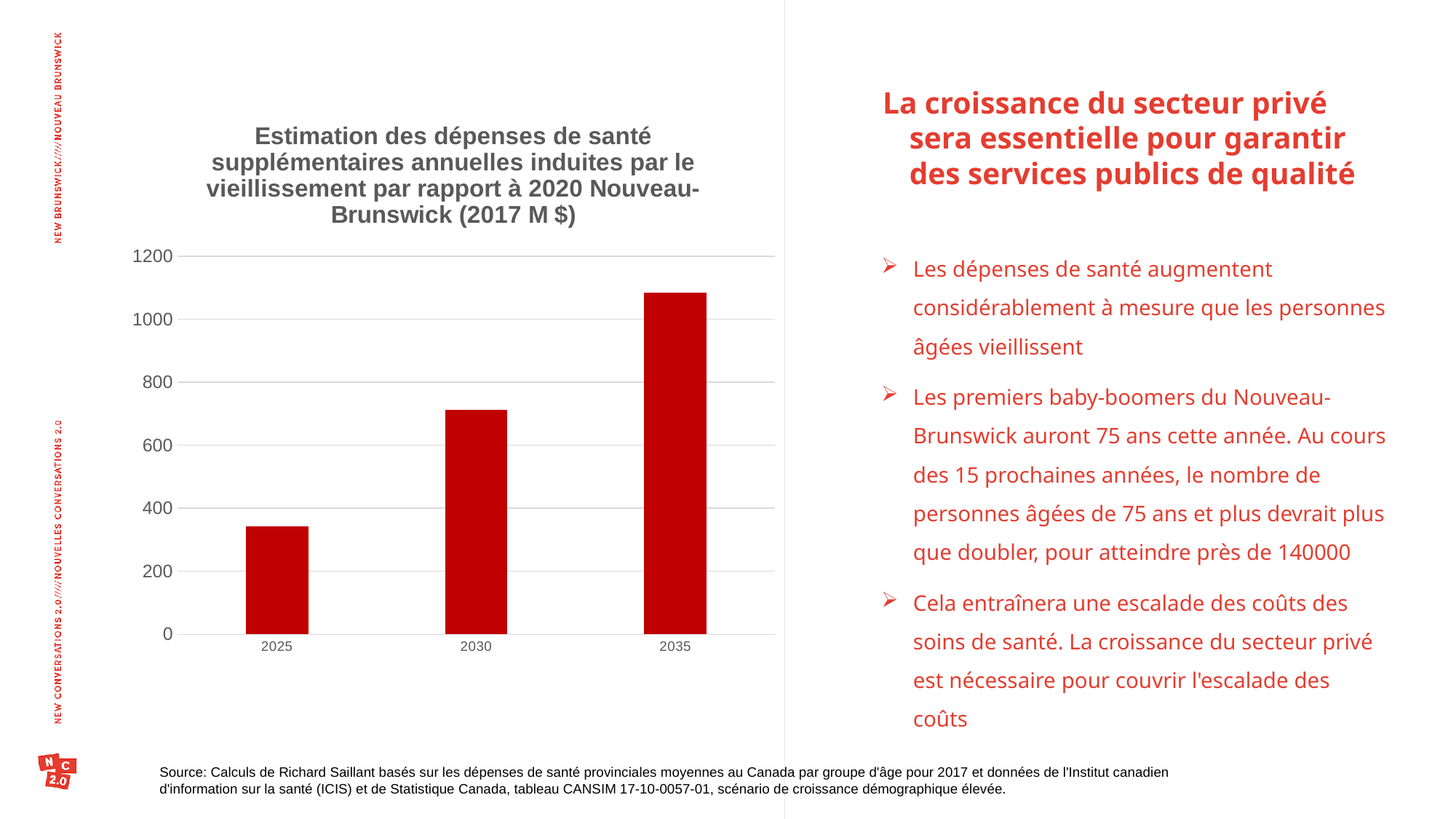
Is the value for 2025 greater or less than 200? greater Is the value for 2030 greater or less than 800? less How many bars (categories) does the chart show? 3 Which year has the lowest estimated additional health spending? 2025 Is the value for 2025 greater or less than 400? less What unit is given in the chart title for the values? 2017 M $ What kind of chart is shown on the slide? bar chart Which year has the highest estimated additional health spending? 2035 Which is larger, the value for 2030 or the value for 2035? 2035 Do the values rise or fall from 2025 to 2035? rise